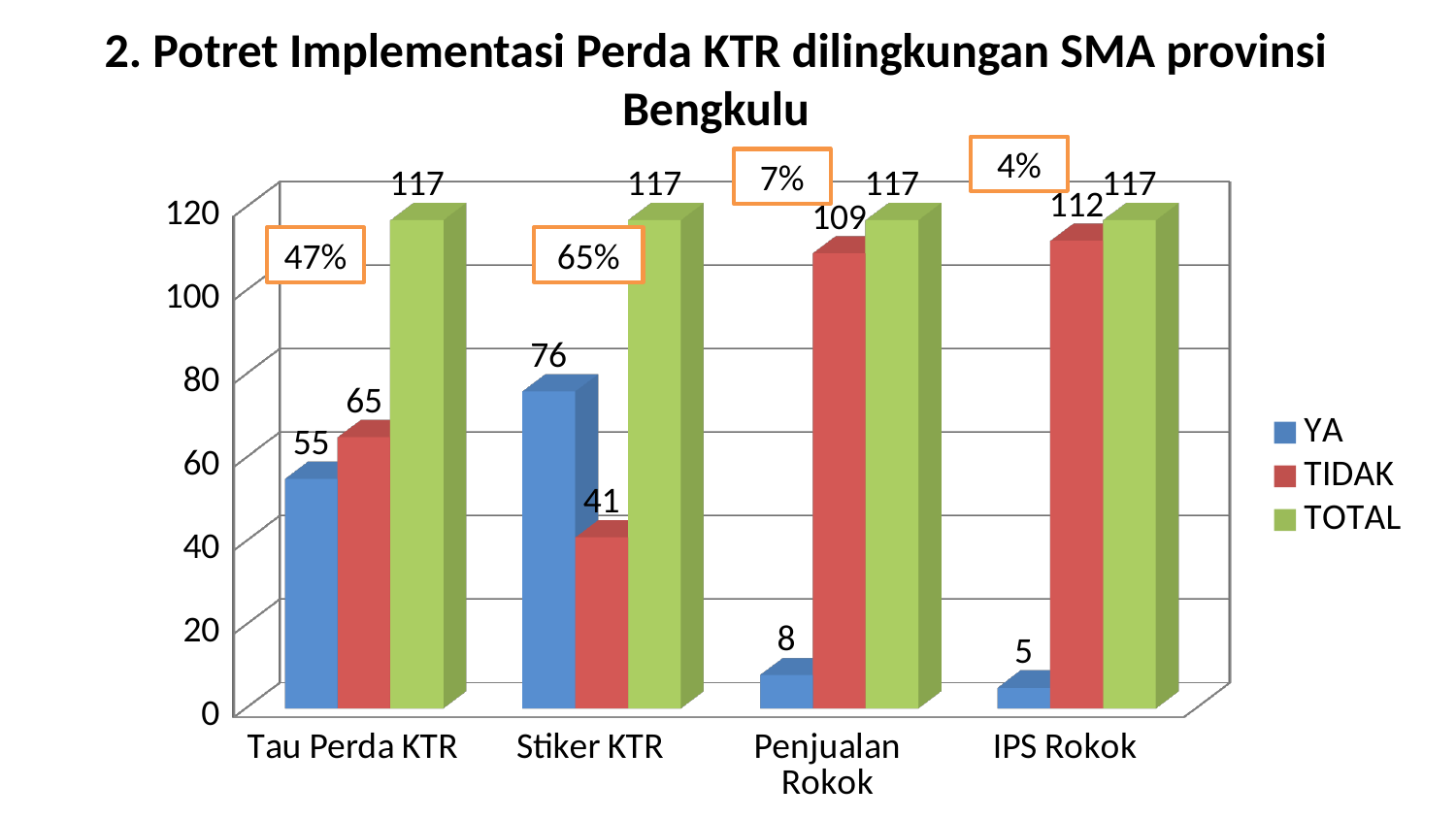
What is the YA value for Stiker KTR? 76 How many categories are shown on the x axis? 4 Which category has the lowest YA value? IPS Rokok How many series does the legend list? 3 What is the difference between the TIDAK and YA values for Tau Perda KTR? 10 What is the TIDAK value for Penjualan Rokok? 109 Which is larger for Stiker KTR, the YA value or the TIDAK value? YA What kind of chart is shown on the slide? Bar chart Which category has the highest YA value? Stiker KTR What is the TIDAK value for Tau Perda KTR? 65 What percentage is shown in the box above the Penjualan Rokok bars? 7% What is the YA value for IPS Rokok? 5